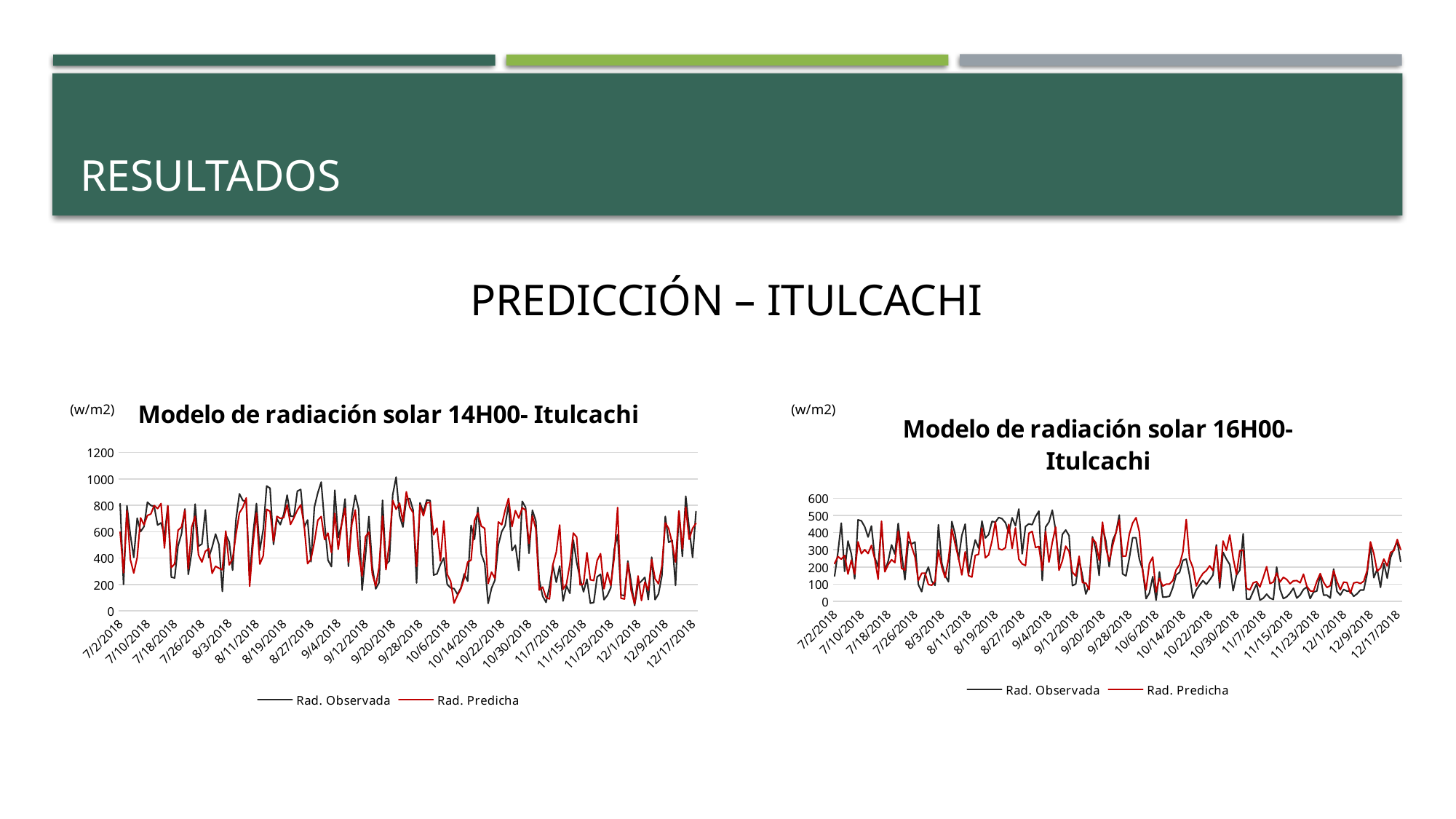
In the 'Modelo de radiación solar 14H00- Itulcachi' chart, are the Rad. Observada values in late November generally higher or lower than in August? lower In the 'Modelo de radiación solar 14H00- Itulcachi' chart, which series is drawn in red? Rad. Predicha What kind of chart is the 'Modelo de radiación solar 14H00- Itulcachi' chart? line chart How many series does the legend of the 'Modelo de radiación solar 14H00- Itulcachi' chart list? 2 In the 'Modelo de radiación solar 14H00- Itulcachi' chart, is the highest value of Rad. Observada greater or less than 1200? less What is the highest value shown on the y axis of the 'Modelo de radiación solar 16H00- Itulcachi' chart? 600 How many series does the legend of the 'Modelo de radiación solar 16H00- Itulcachi' chart list? 2 In the 'Modelo de radiación solar 16H00- Itulcachi' chart, is the highest value of Rad. Observada greater or less than 600? less In the 'Modelo de radiación solar 16H00- Itulcachi' chart, do the values generally rise or fall from late September to mid November? fall What kind of chart is the 'Modelo de radiación solar 16H00- Itulcachi' chart? line chart